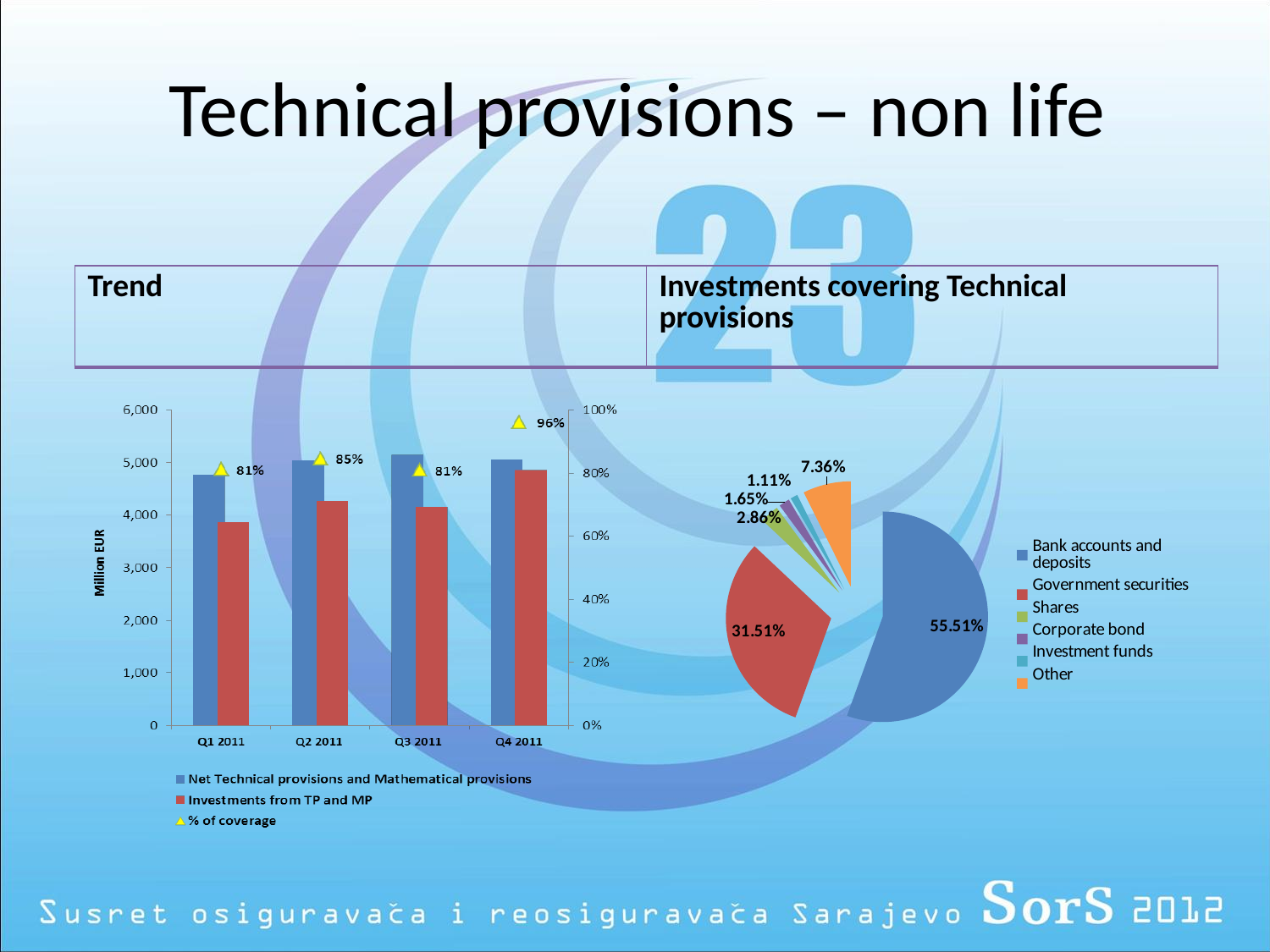
On the Trend chart, what is the difference in % of coverage between Q4 2011 and Q1 2011? 15 percentage points On the Investments covering Technical provisions chart, which category has the smallest share? Investment funds On the Investments covering Technical provisions chart, what is the share of Government securities? 31.51% On the Trend chart, which quarter has the highest % of coverage? Q4 2011 On the Investments covering Technical provisions chart, what share do Bank accounts and deposits have? 55.51% On the Trend chart, what is the % of coverage for Q2 2011? 85% On the Trend chart, what is the % of coverage for Q4 2011? 96% On the Trend chart, how many quarters are shown on the x axis? 4 On the Trend chart, is the value of Investments from TP and MP for Q1 2011 greater or less than 4,000? less On the Trend chart, how many series does the legend list? 3 On the Trend chart, is the value of Investments from TP and MP for Q4 2011 greater or less than 4,000? greater What kind of chart is the Investments covering Technical provisions chart? Pie chart